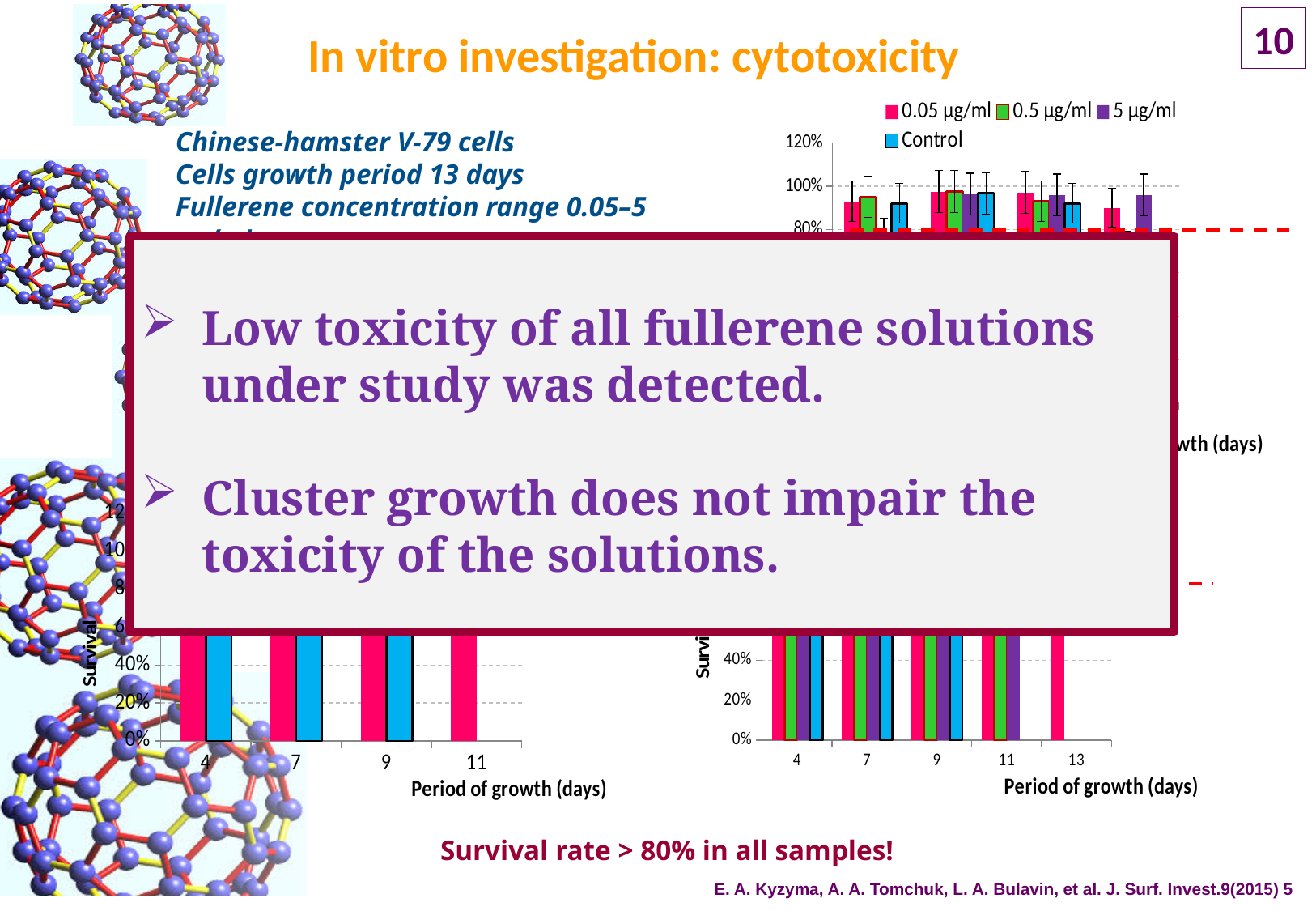
In the bottom-left chart, is the value for the pink series at day 11 greater or less than 40%? greater What is the x-axis label of the bottom-right chart? Period of growth (days) What kind of chart is the bottom-left chart on the slide? bar chart How many series does the legend of the top-right chart list? 4 How many periods of growth are shown on the x axis of the bottom-right chart? 5 What kind of chart is the top-right chart on the slide? bar chart How many periods of growth are shown on the x axis of the bottom-left chart? 4 In the top-right chart, which series is shown in blue according to the legend? Control